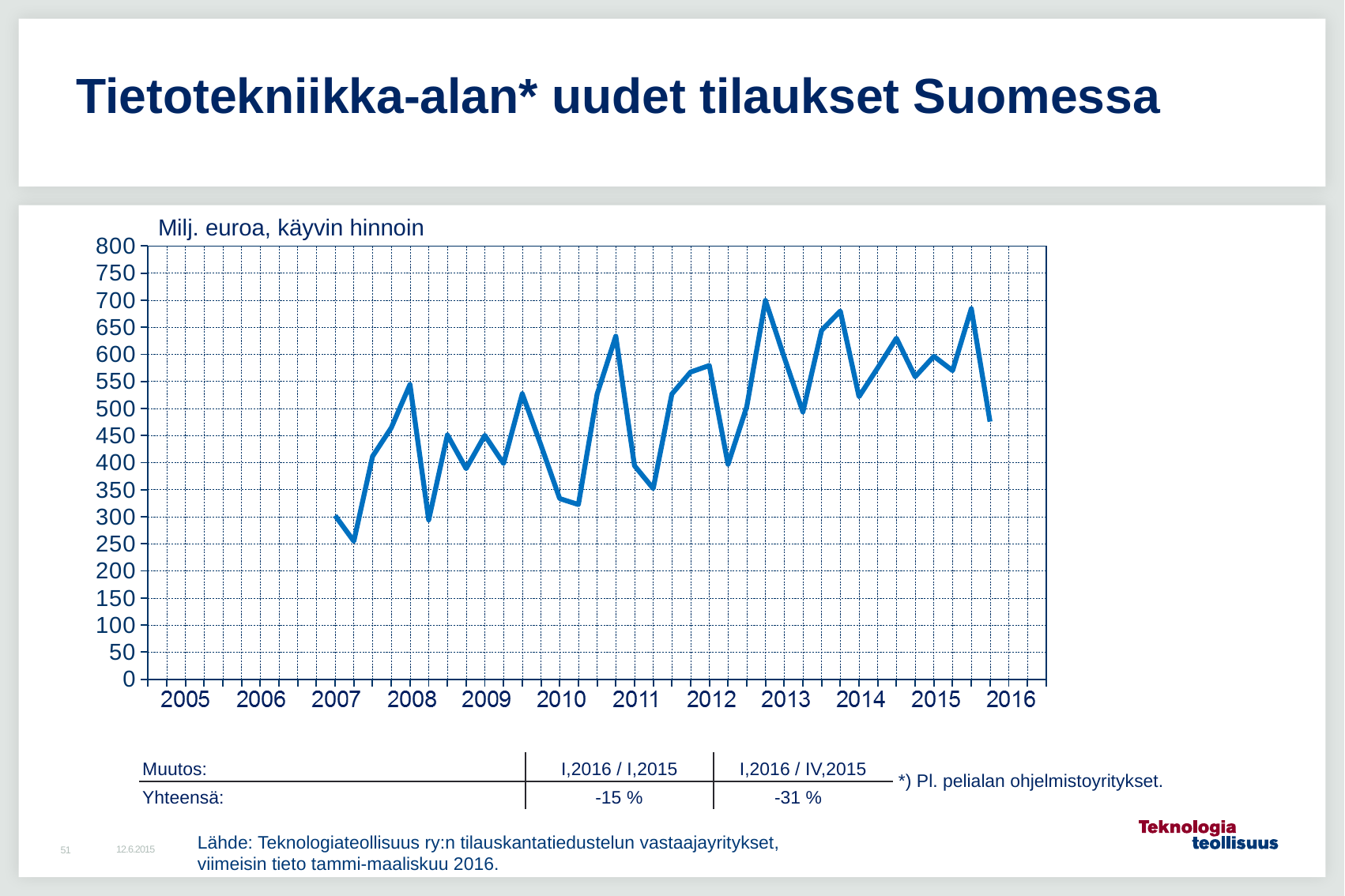
Is the lowest point of the line, near 2007, greater or less than 300? less Does the line rise or fall between the last two plotted points, ending at 2016? fall How many lines (series) are plotted on the chart? 1 Is the peak value reached around 2008 greater or less than 500? greater Is the last plotted value, at 2016, greater or less than 500? less What is the highest value shown on the y axis? 800 What kind of chart is shown on the slide? line chart In the table below the chart, what is the change (Muutos) for I,2016 / IV,2015? -31 % What unit label is shown above the y axis of the chart? Milj. euroa, käyvin hinnoin What is the title of the slide's chart? Tietotekniikka-alan* uudet tilaukset Suomessa